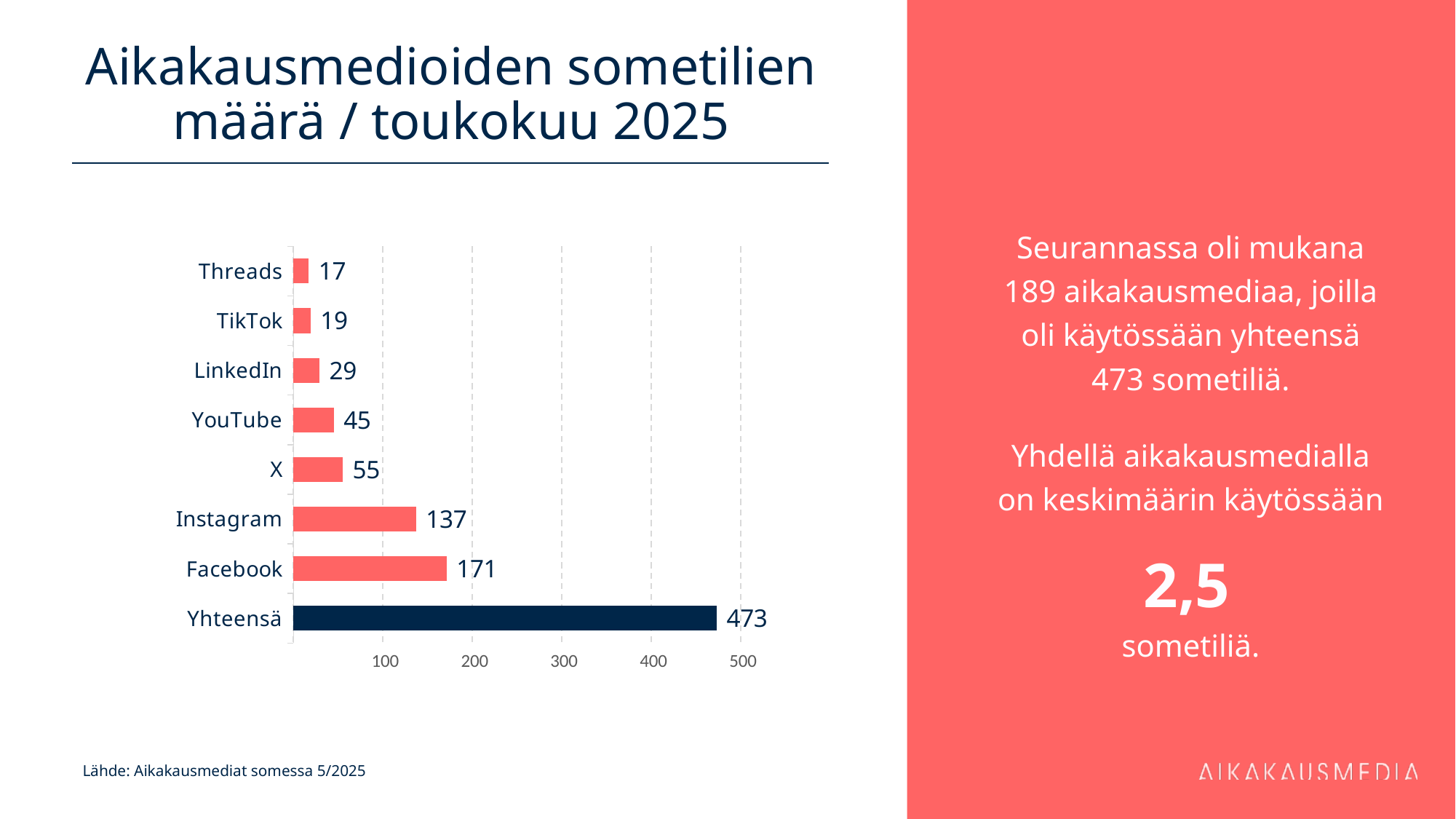
Which platform has the lowest value? Threads What is the difference between the values for Facebook and Instagram? 34 Is the value for Instagram greater or less than 100? greater What is the value for Facebook? 171 What is the value for LinkedIn? 29 What is the value for Instagram? 137 Which is larger, the value for X or the value for YouTube? X How many bars are shown in the chart, including the Yhteensä total bar? 8 Excluding the Yhteensä total bar, which platform has the highest value? Facebook What kind of chart is shown on the slide? Bar chart What is the title of the chart on the slide? Aikakausmedioiden sometilien määrä / toukokuu 2025 What is the value shown for Yhteensä? 473